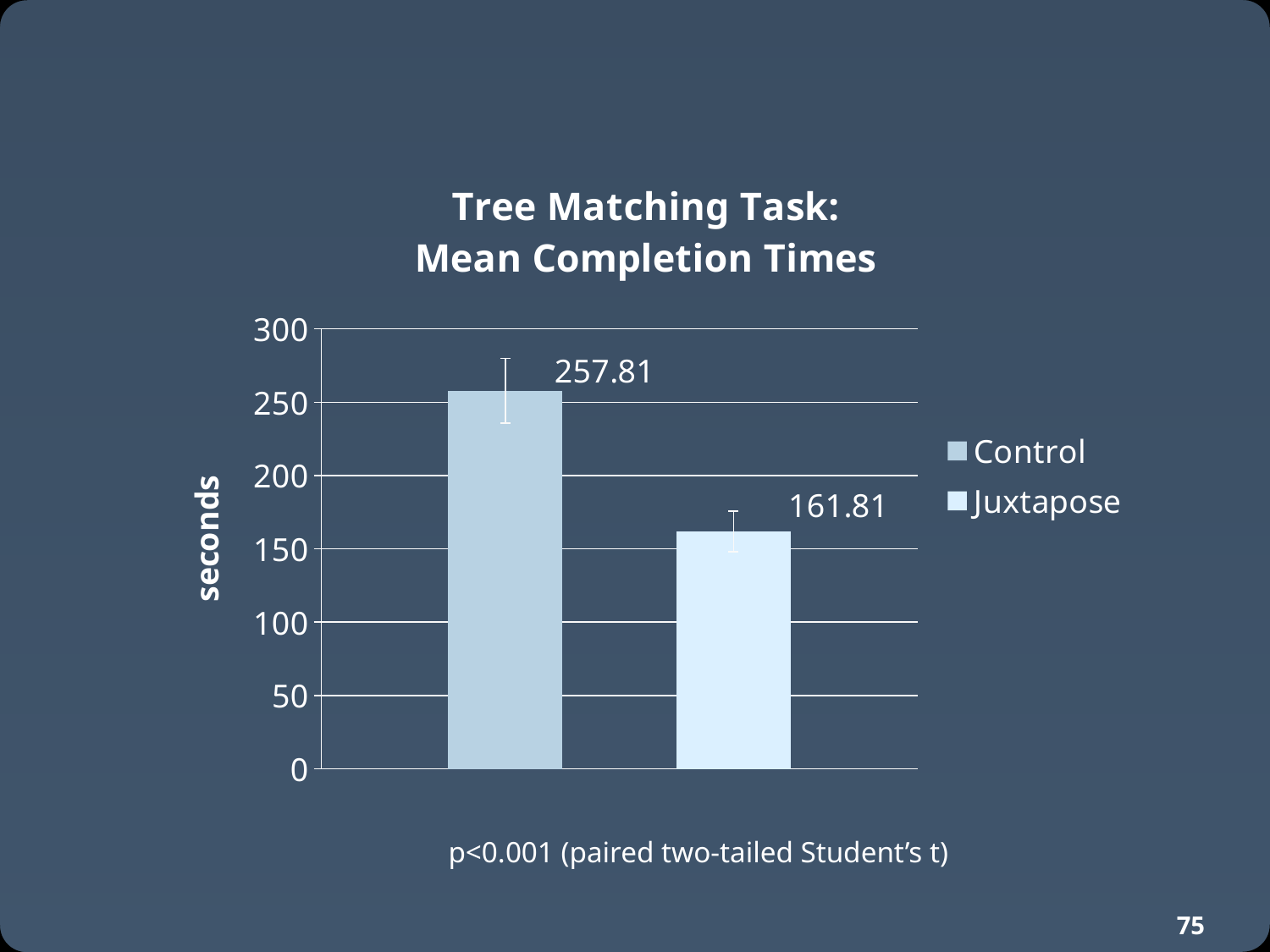
How many series does the legend list? 2 Is the value for Control greater or less than 250? greater What is the mean completion time for the Juxtapose condition? 161.81 What kind of chart is shown on the slide? bar chart What is the difference between the Control and Juxtapose mean completion times? 96 Is the Control mean completion time larger or smaller than the Juxtapose mean completion time? larger Which condition has the lower mean completion time? Juxtapose What is the mean completion time for the Control condition? 257.81 What is the label on the vertical axis of the chart? seconds Which condition has the higher mean completion time? Control How many bars are plotted in the chart? 2 Is the value for Juxtapose greater or less than 200? less